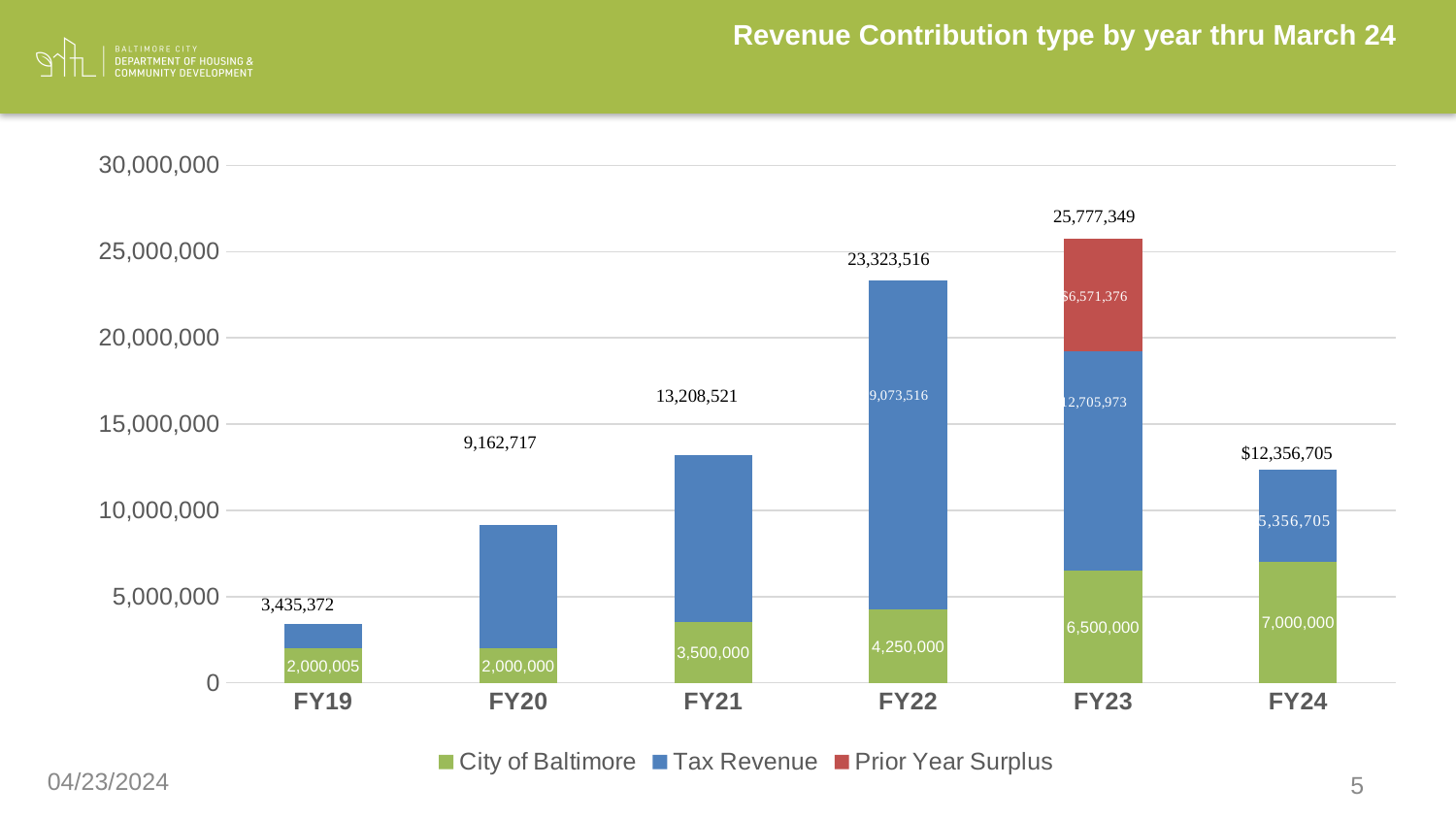
Which series is shown in red? Prior Year Surplus What is the total revenue contribution labeled for FY23? 25,777,349 How many series does the legend list? 3 Which fiscal year has the lowest total revenue contribution? FY19 What kind of chart is shown on the slide? Stacked bar chart What is the City of Baltimore contribution for FY21? 3,500,000 Which is larger, the City of Baltimore contribution in FY21 or in FY22? FY22 Is the total for FY20 greater or less than 10,000,000? less What is the Tax Revenue value for FY24? 5,356,705 How much larger is the City of Baltimore contribution in FY24 than in FY23? 500,000 How many fiscal years are shown on the x axis? 6 Which fiscal year has the highest total revenue contribution? FY23